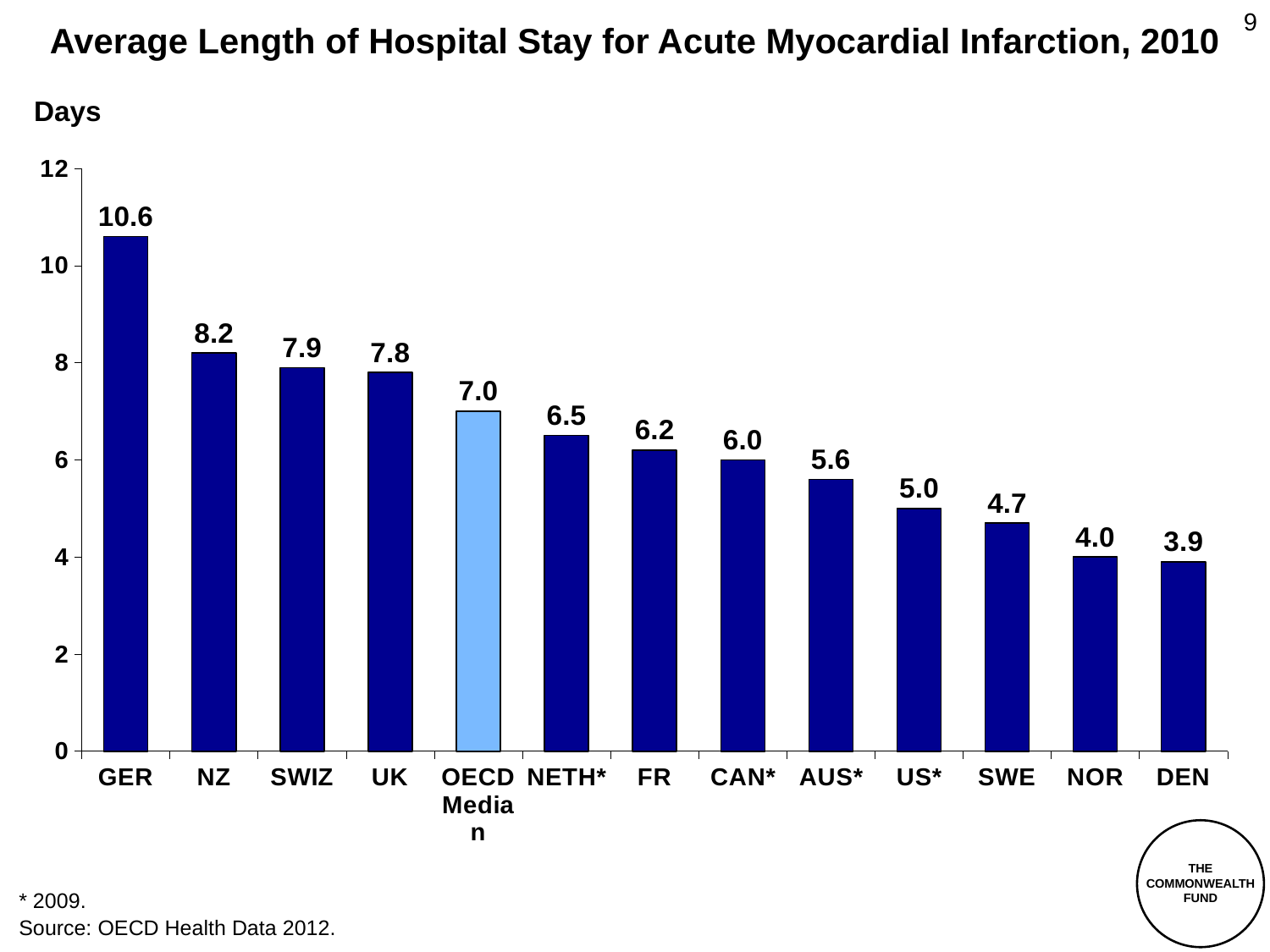
Do the values rise or fall from left to right along the x axis? Fall Which country has the lowest average length of hospital stay? DEN What is the average length of hospital stay for acute myocardial infarction in Germany (GER)? 10.6 What is the value shown for the OECD Median? 7.0 What is the value shown for US*? 5.0 What is the difference between the UK value and the OECD Median? 0.8 Is the value for NETH* greater or less than 6? greater Which has a longer average hospital stay, NZ or SWIZ? NZ What kind of chart is shown on the slide? Bar chart How many bars are shown in the chart? 13 What is the difference in days between GER and DEN? 6.7 Which country has the highest average length of hospital stay? GER